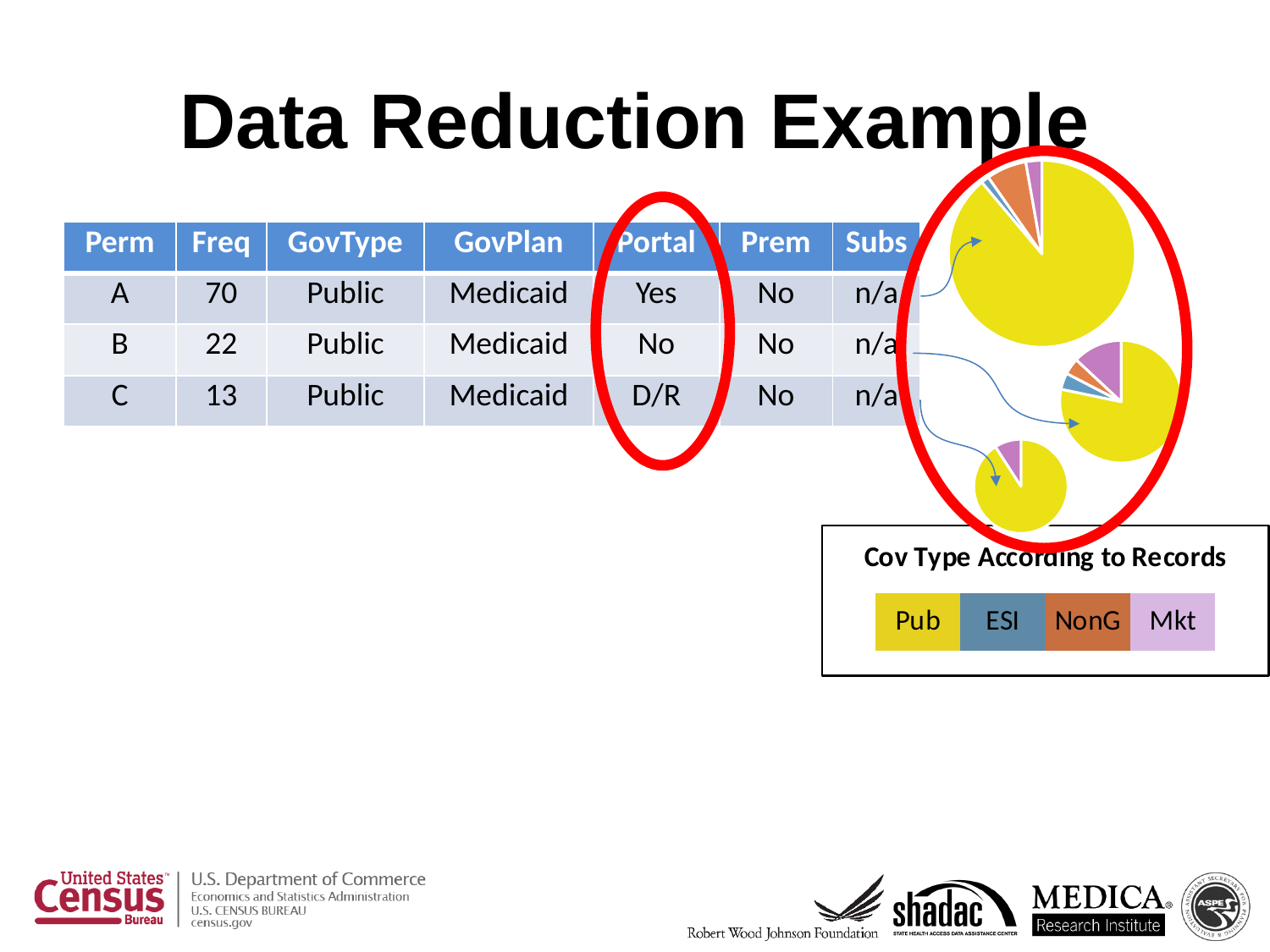
What kind of chart is used to show coverage type on the slide? pie chart How many coverage types does the legend list? 4 Which coverage type has the largest slice in the bottom-left pie chart? Pub Which legend entry is shown in blue? ESI How many pie charts are shown on the slide? 3 In the bottom-left pie chart, which slice is larger, Pub or Mkt? Pub In the top pie chart, which slice is larger, Pub or ESI? Pub Which coverage type has the largest slice in the middle-right pie chart? Pub In the middle-right pie chart, which slice is larger, Mkt or ESI? Mkt What is the title of the legend for the pie charts? Cov Type According to Records What colour represents Pub in the legend? yellow Which coverage type has the largest slice in the top pie chart? Pub